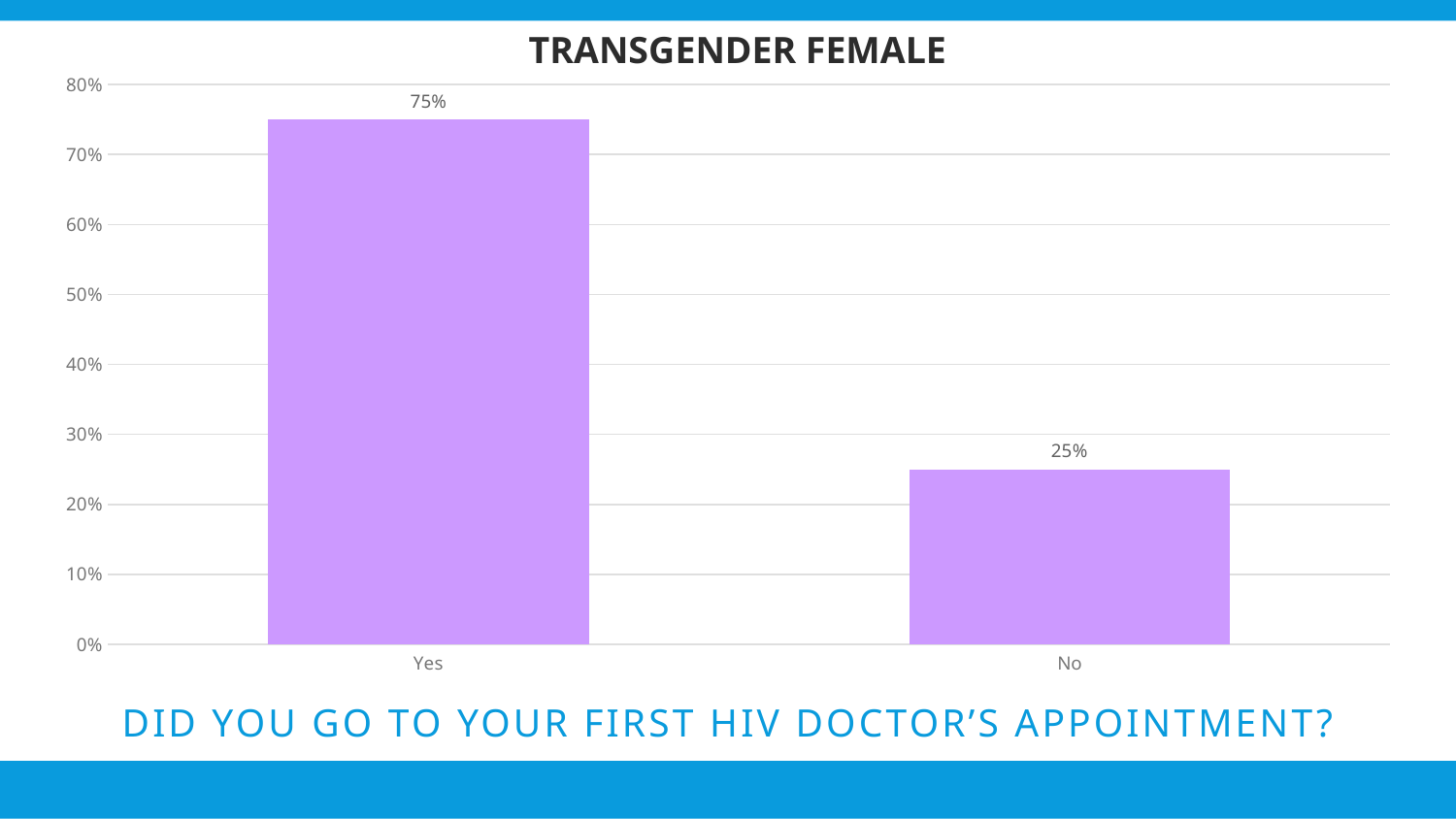
What is the value for No? 25% Which category has the highest value? Yes What is the highest value shown on the y axis? 80% What is the title of the chart? TRANSGENDER FEMALE Is the value for No greater or less than 30%? less What kind of chart is shown on the slide? bar chart What is the difference between the values for Yes and No? 50% Is the value for Yes greater or less than 70%? greater Which category has the lowest value? No How many categories are shown on the x axis? 2 Which is larger, the value for Yes or the value for No? Yes What is the value for Yes? 75%